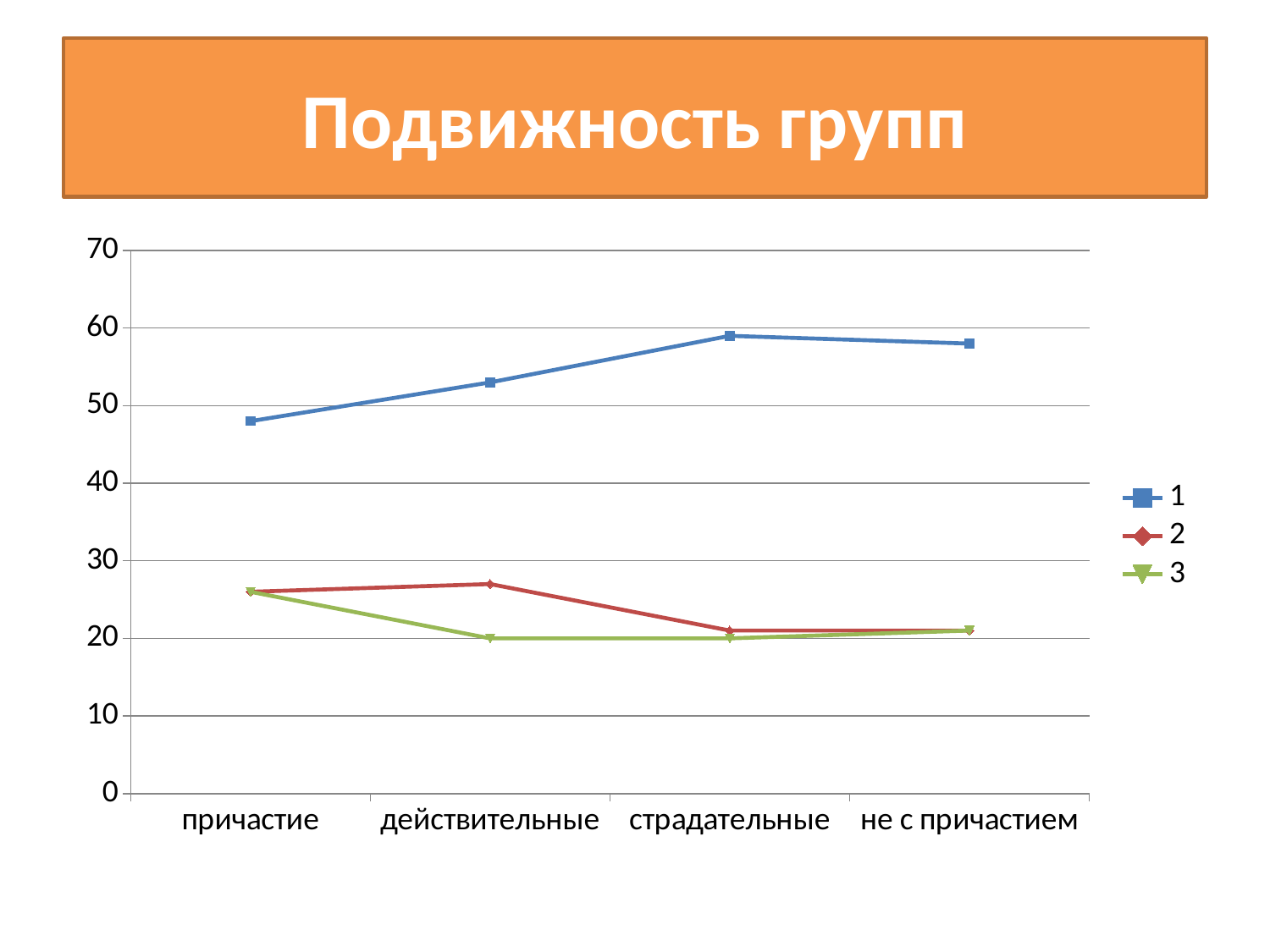
At страдательные, which series has the larger value, 1 or 2? 1 Is the value of series 2 for действительные greater or less than 30? less How many series does the legend list? 3 Is the value of series 1 for причастие greater or less than 50? less Does series 1 rise or fall from причастие to страдательные? rise Is the value of series 1 for страдательные greater or less than 50? greater What kind of chart is shown on the slide? line chart How many categories are shown on the x axis? 4 For series 1, which category has the lowest value? причастие At действительные, which series has the larger value, 2 or 3? 2 What is the title of the slide above the chart? Подвижность групп